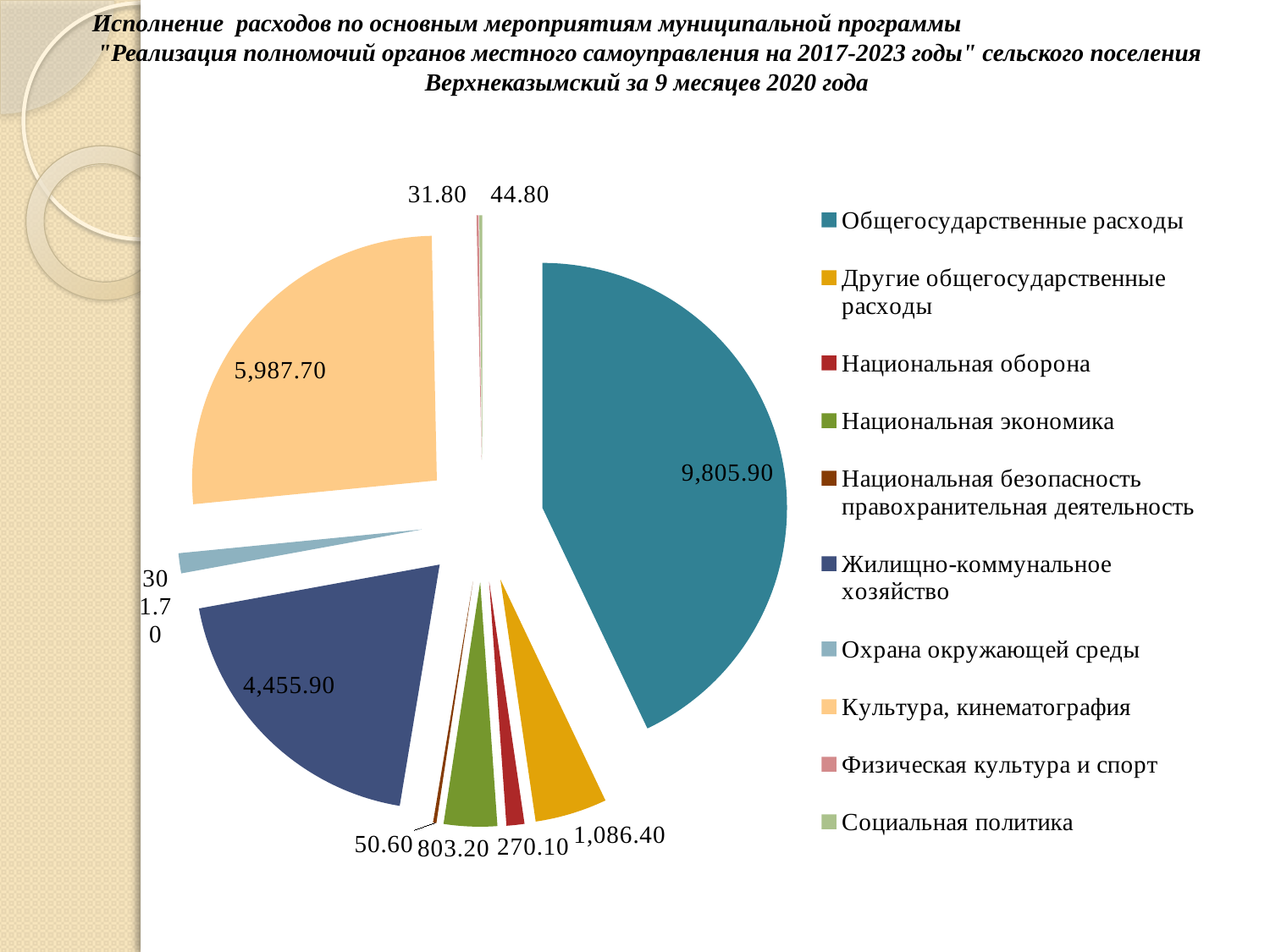
What is the value shown for Культура, кинематография? 5,987.70 What is the value shown for Национальная экономика? 803.20 What is the value shown for Национальная оборона? 270.10 What is the value shown for Общегосударственные расходы? 9,805.90 Which category has the largest slice of the pie? Общегосударственные расходы How many entries does the legend list? 10 What is the difference between the values for Общегосударственные расходы and Культура, кинематография? 3,818.20 What is the value shown for Жилищно-коммунальное хозяйство? 4,455.90 What kind of chart is shown on the slide? Pie chart What is the difference between the values for Другие общегосударственные расходы and Национальная экономика? 283.20 What is the value shown for Другие общегосударственные расходы? 1,086.40 Which is larger: Культура, кинематография or Жилищно-коммунальное хозяйство? Культура, кинематография